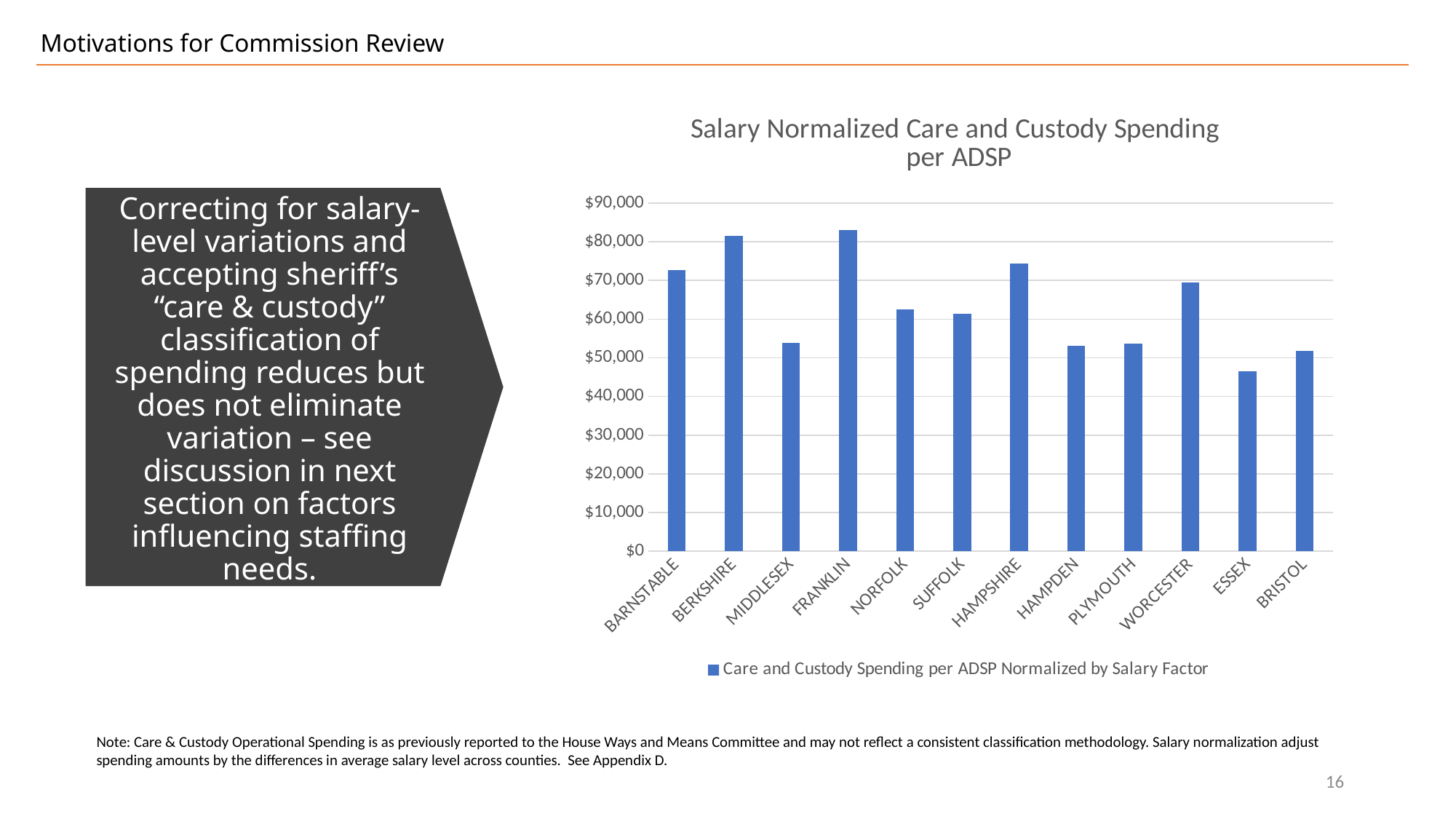
Is the value for Hampshire greater or less than $70,000? greater Which county has the lowest salary normalized care and custody spending per ADSP? Essex Is the value for Norfolk greater or less than $60,000? greater Is the value for Middlesex greater or less than $50,000? greater How many counties are shown on the x axis of the chart? 12 Which has the higher value, Berkshire or Middlesex? Berkshire What kind of chart is shown on the slide? Bar chart What is the title of the chart? Salary Normalized Care and Custody Spending per ADSP Which has the higher value, Hampshire or Norfolk? Hampshire How many series does the chart's legend list? 1